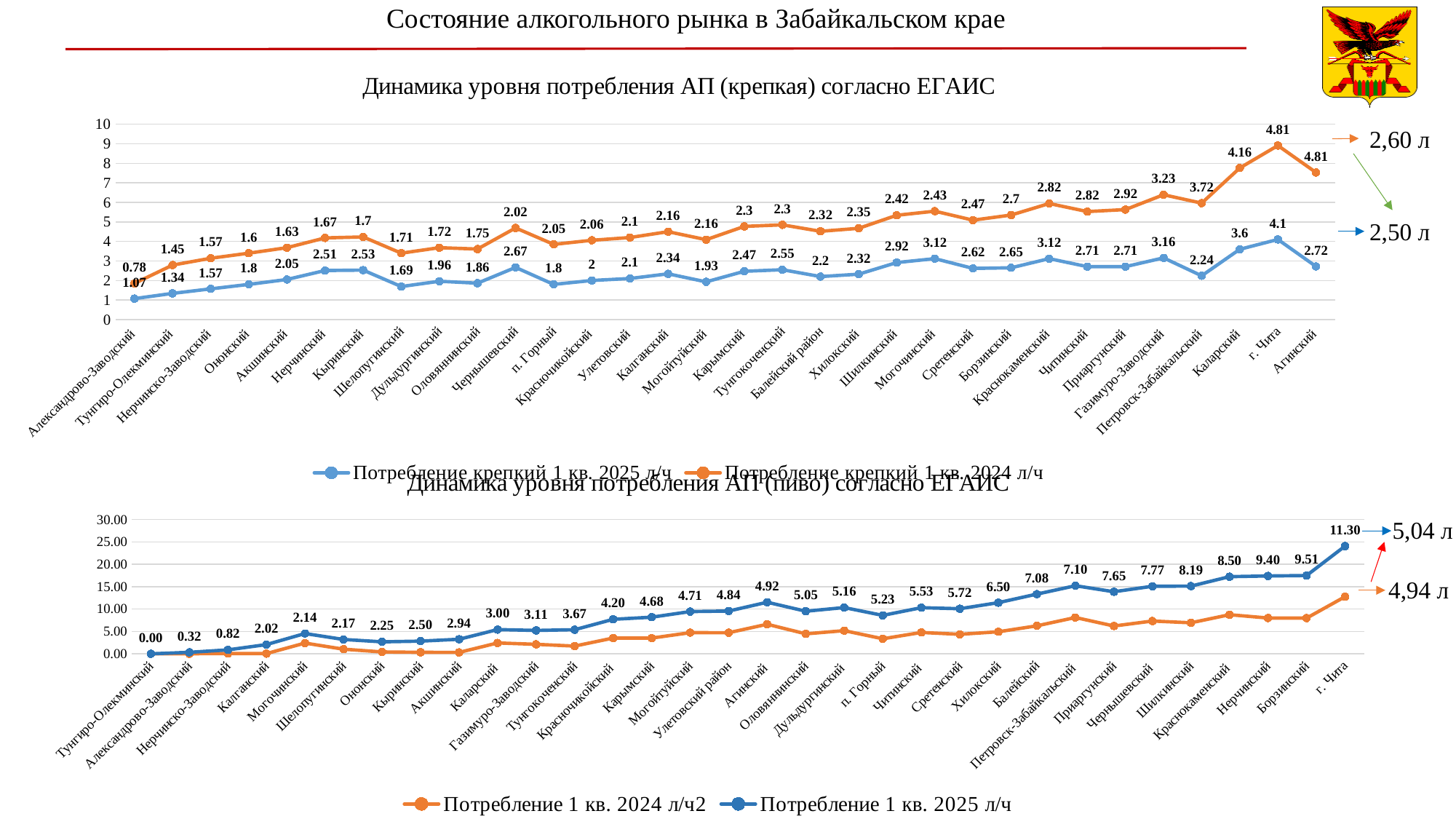
In the top chart (крепкая), on the "Потребление крепкий 1 кв. 2025 л/ч" series, which is larger: Каларский or Петровск-Забайкальский? Каларский In the top chart (крепкая), what is the data label for Агинский on the "Потребление крепкий 1 кв. 2025 л/ч" series? 2.72 In the bottom chart (пиво), what is the data label for Тунгиро-Олекминский? 0.00 What type of chart is the top chart titled "Динамика уровня потребления АП (крепкая) согласно ЕГАИС"? Line chart In the bottom chart (пиво), what is the data label for г. Чита? 11.30 In the top chart (крепкая), which category has the highest value on the "Потребление крепкий 1 кв. 2025 л/ч" series? г. Чита In the bottom chart (пиво), how many categories are shown on the x axis? 32 In the top chart (крепкая), how many series does the legend list? 2 In the bottom chart (пиво), what is the difference between the labelled values for г. Чита (11.30) and Борзинский (9.51)? 1.79 In the top chart (крепкая), what is the data label for г. Чита on the "Потребление крепкий 1 кв. 2025 л/ч" series? 4.1 In the top chart (крепкая), what is the difference between the two labelled values for г. Чита (4.81 and 4.1)? 0.71 In the top chart (крепкая), which category has the lowest value on the "Потребление крепкий 1 кв. 2025 л/ч" series? Александрово-Заводский